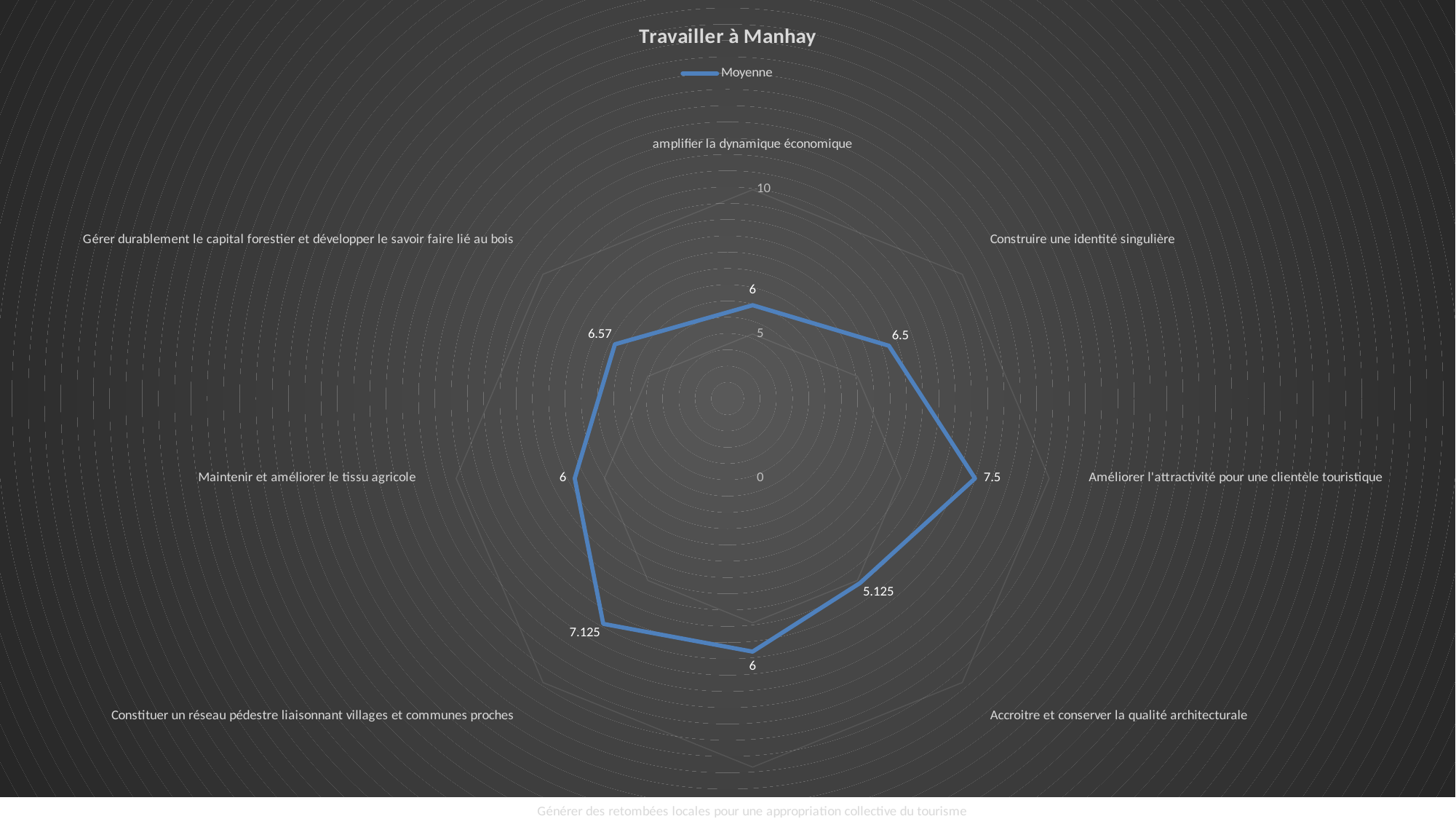
Which category has the highest Moyenne value? Améliorer l'attractivité pour une clientèle touristique How many series does the legend list? 1 What is the Moyenne value for 'Constituer un réseau pédestre liaisonnant villages et communes proches'? 7.125 What is the title of the chart? Travailler à Manhay What is the Moyenne value for 'Améliorer l'attractivité pour une clientèle touristique'? 7.5 Which is larger: the value for 'Constituer un réseau pédestre liaisonnant villages et communes proches' or the value for 'Maintenir et améliorer le tissu agricole'? Constituer un réseau pédestre liaisonnant villages et communes proches What is the difference between the highest value (7.5) and the lowest value (5.125)? 2.375 What is the Moyenne value for 'Construire une identité singulière'? 6.5 What is the Moyenne value for 'Gérer durablement le capital forestier et développer le savoir faire lié au bois'? 6.57 What type of chart is shown on the slide? Radar chart Which category has the lowest Moyenne value? Accroitre et conserver la qualité architecturale How many categories (axes) does the radar chart have? 8